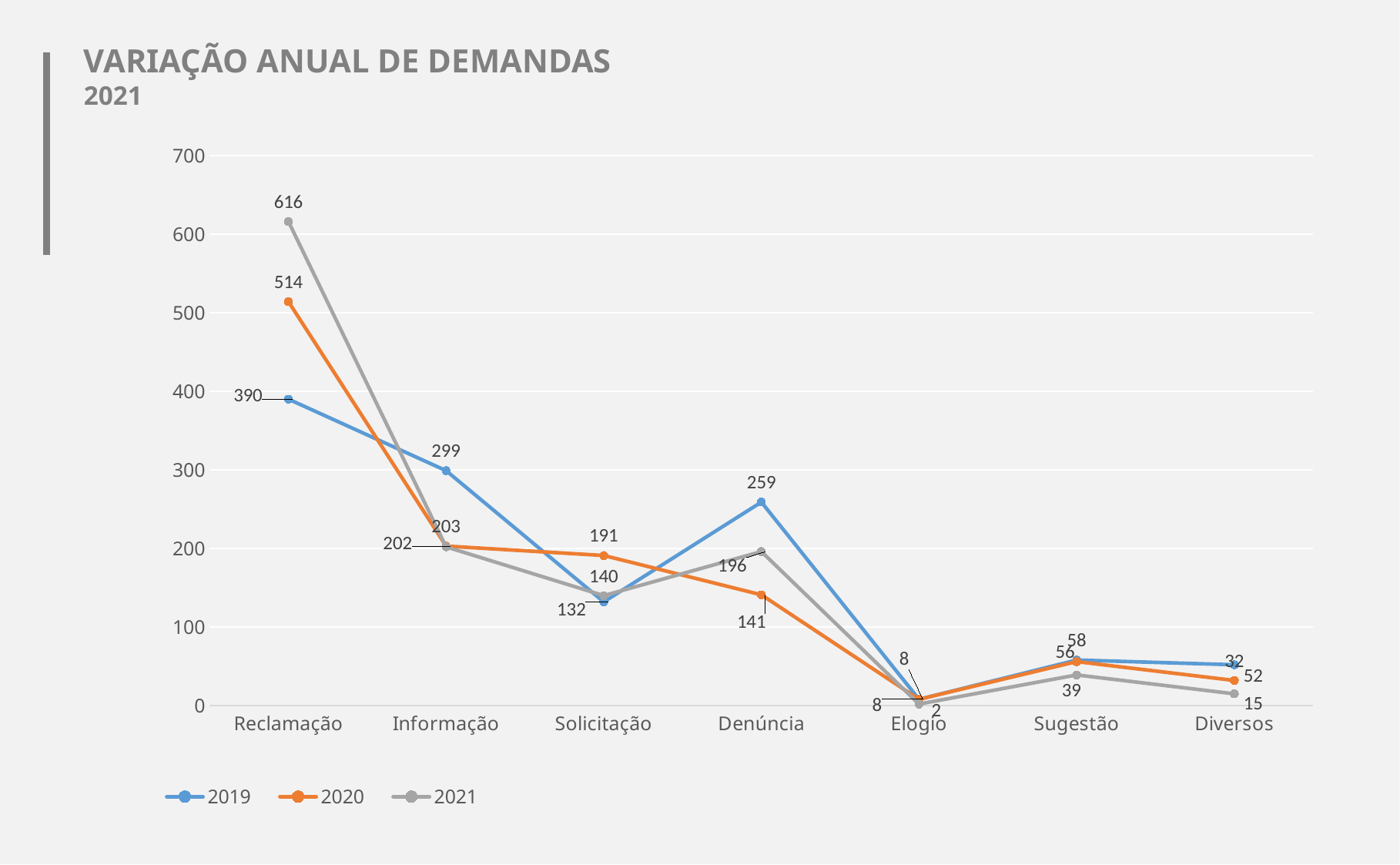
What is the value for Reclamação in the 2020 series? 514 What is the difference between the 2021 and 2020 values for Reclamação? 102 How many series does the legend list? 3 How many categories are shown on the x axis? 7 What is the value for Solicitação in the 2020 series? 191 Which category has the highest value in the 2021 series? Reclamação What is the value for Denúncia in the 2019 series? 259 Is the 2019 value for Diversos greater or less than 100? less What type of chart is shown on the slide? line chart For Denúncia, which series has the larger value, 2019 or 2020? 2019 Which category has the lowest value in the 2021 series? Elogio What is the value for Reclamação in the 2021 series? 616